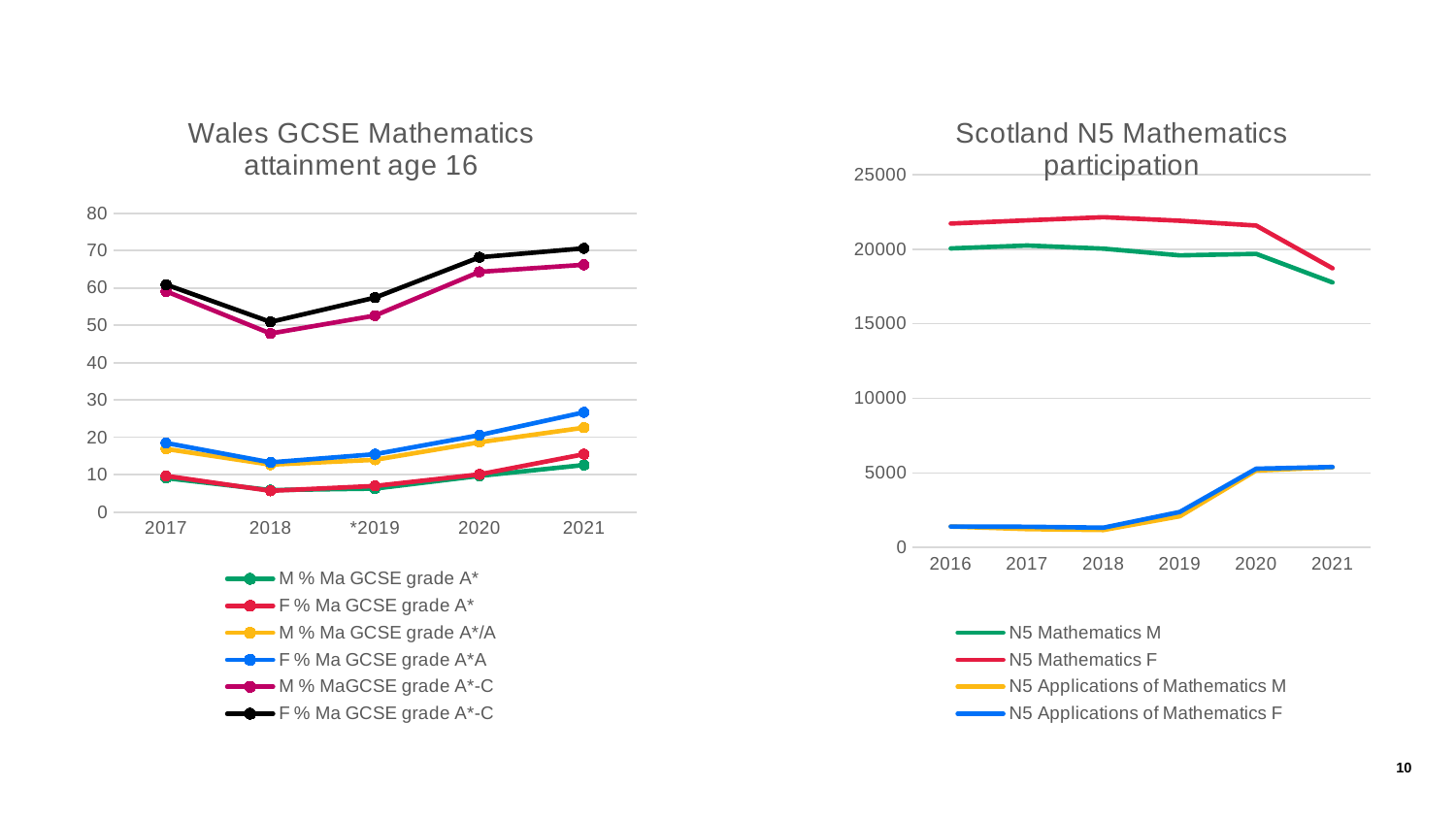
In the Scotland N5 Mathematics participation chart, does N5 Mathematics F rise or fall from 2020 to 2021? fall In the Wales GCSE Mathematics attainment age 16 chart, is the value for F % Ma GCSE grade A*-C in 2021 greater or less than 60? greater What kind of chart is the Wales GCSE Mathematics attainment age 16 chart? line chart How many series does the legend of the Wales GCSE Mathematics attainment age 16 chart list? 6 In the Wales GCSE Mathematics attainment age 16 chart, which series has the highest value in 2021? F % Ma GCSE grade A*-C In the Scotland N5 Mathematics participation chart, which is larger in 2021, N5 Mathematics F or N5 Mathematics M? N5 Mathematics F In the Scotland N5 Mathematics participation chart, which series has the highest value in 2018? N5 Mathematics F How many series does the legend of the Scotland N5 Mathematics participation chart list? 4 How many years are shown on the x axis of the Scotland N5 Mathematics participation chart? 6 In the Scotland N5 Mathematics participation chart, is the value for N5 Mathematics M in 2021 greater or less than 20000? less In the Wales GCSE Mathematics attainment age 16 chart, is the value for M % Ma GCSE grade A* in 2018 greater or less than 10? less How many years are shown on the x axis of the Wales GCSE Mathematics attainment age 16 chart? 5